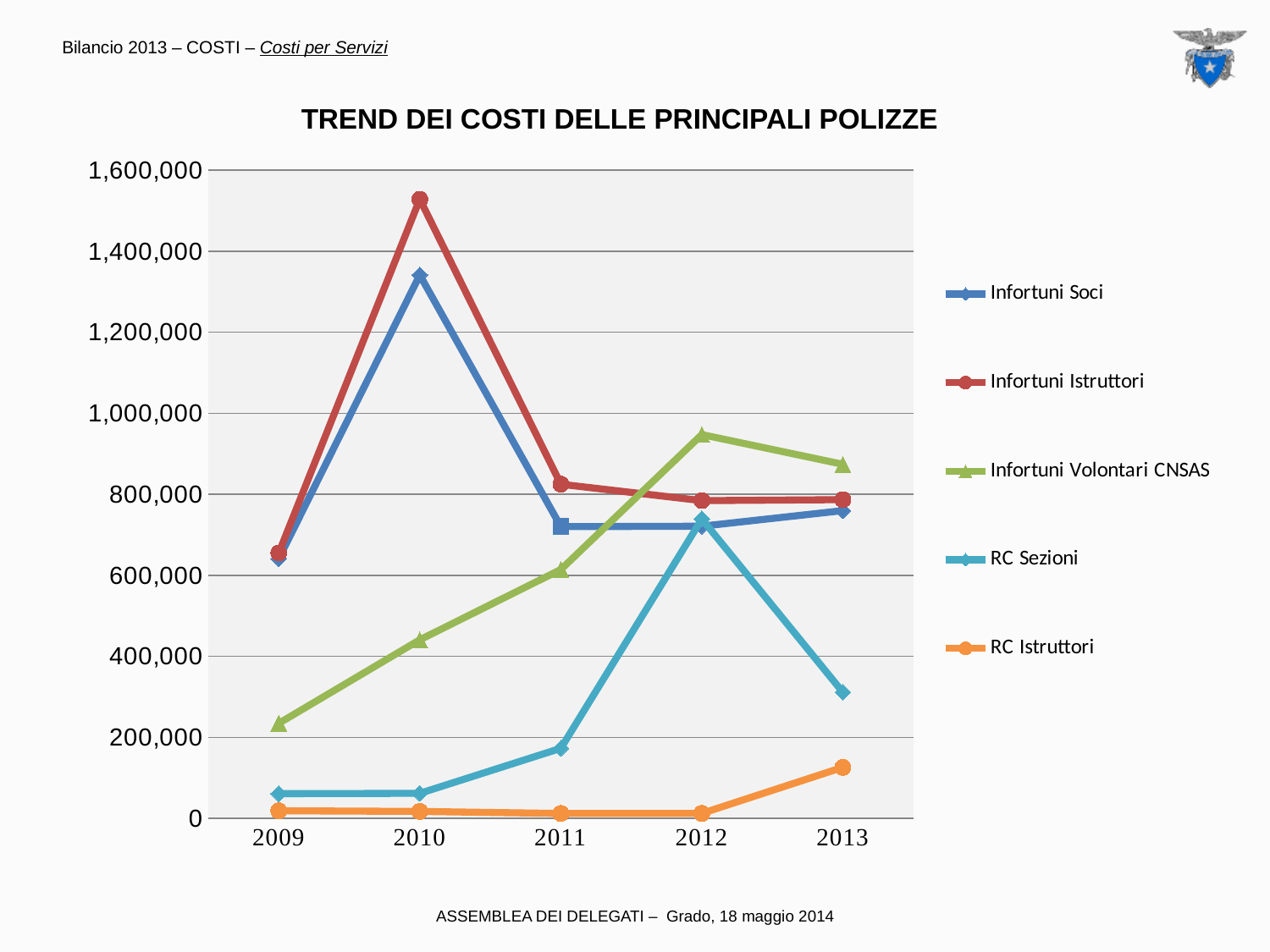
What is the title of the chart? TREND DEI COSTI DELLE PRINCIPALI POLIZZE Is the value for RC Sezioni in 2013 greater or less than 400,000? less How many series does the legend list? 5 Which series has the highest value in 2010? Infortuni Istruttori In which year does Infortuni Soci reach its highest value? 2010 Does the value for Infortuni Volontari CNSAS rise or fall from 2009 to 2012? rise Is the value for Infortuni Volontari CNSAS in 2012 greater or less than 800,000? greater Which series has the lowest value in 2013? RC Istruttori Is the value for Infortuni Istruttori in 2010 greater or less than 1,400,000? greater What kind of chart is shown on the slide? line chart In 2012, which is larger: RC Sezioni or RC Istruttori? RC Sezioni How many years are shown on the x axis? 5